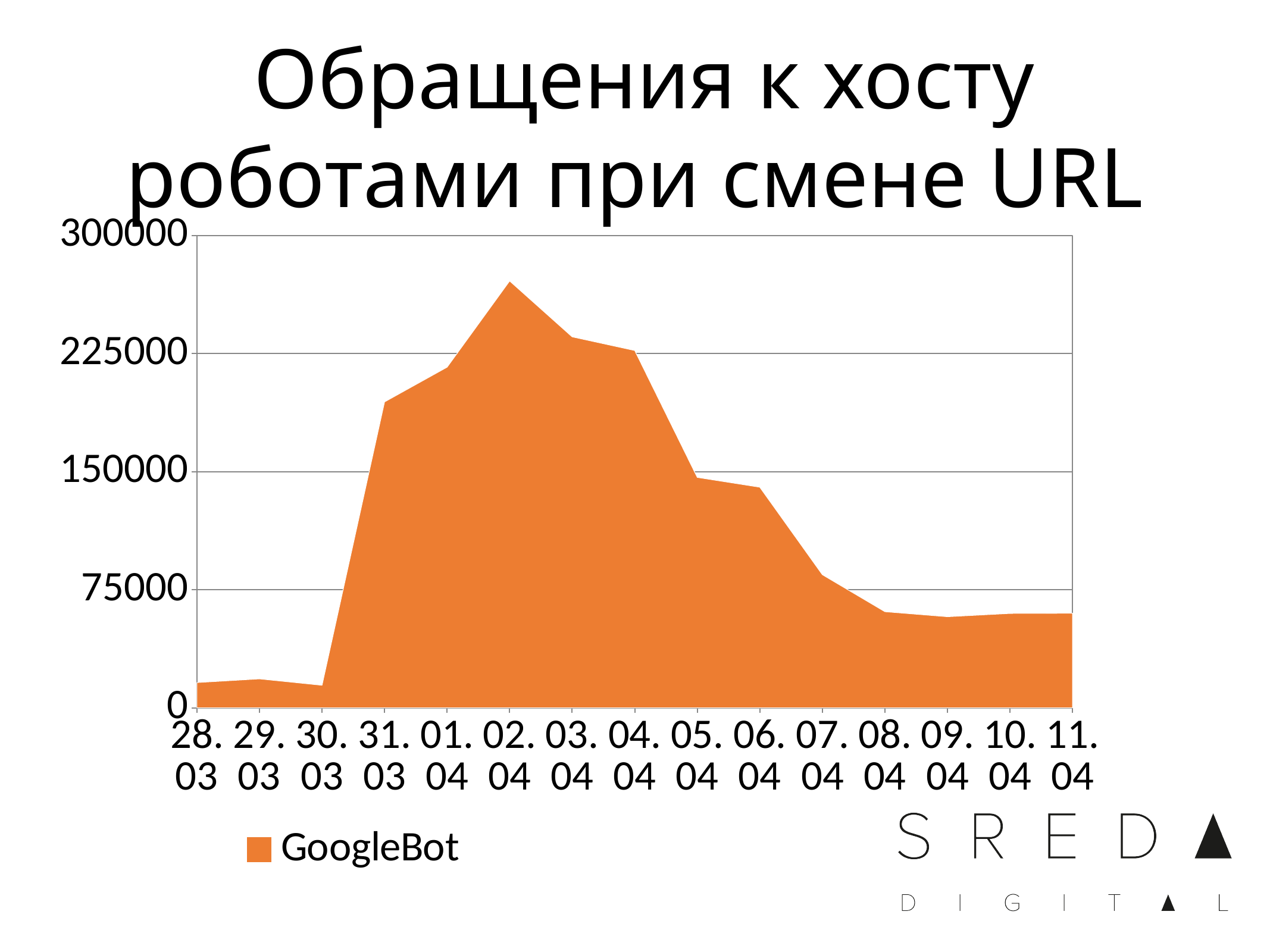
Is the value for 02.04 greater or less than 225000? greater What kind of chart is shown on the slide? area chart How many series does the legend list? 1 Is the value for 11.04 greater or less than 75000? less On which date does the GoogleBot series reach its highest value? 02.04 Which date has the larger value, 02.04 or 11.04? 02.04 Is the value for 31.03 greater or less than 150000? greater Do the values rise or fall from 02.04 to 08.04? fall How many dates are shown along the x axis? 15 What is the name of the series shown in the legend? GoogleBot What is the title of the chart on the slide? Обращения к хосту роботами при смене URL